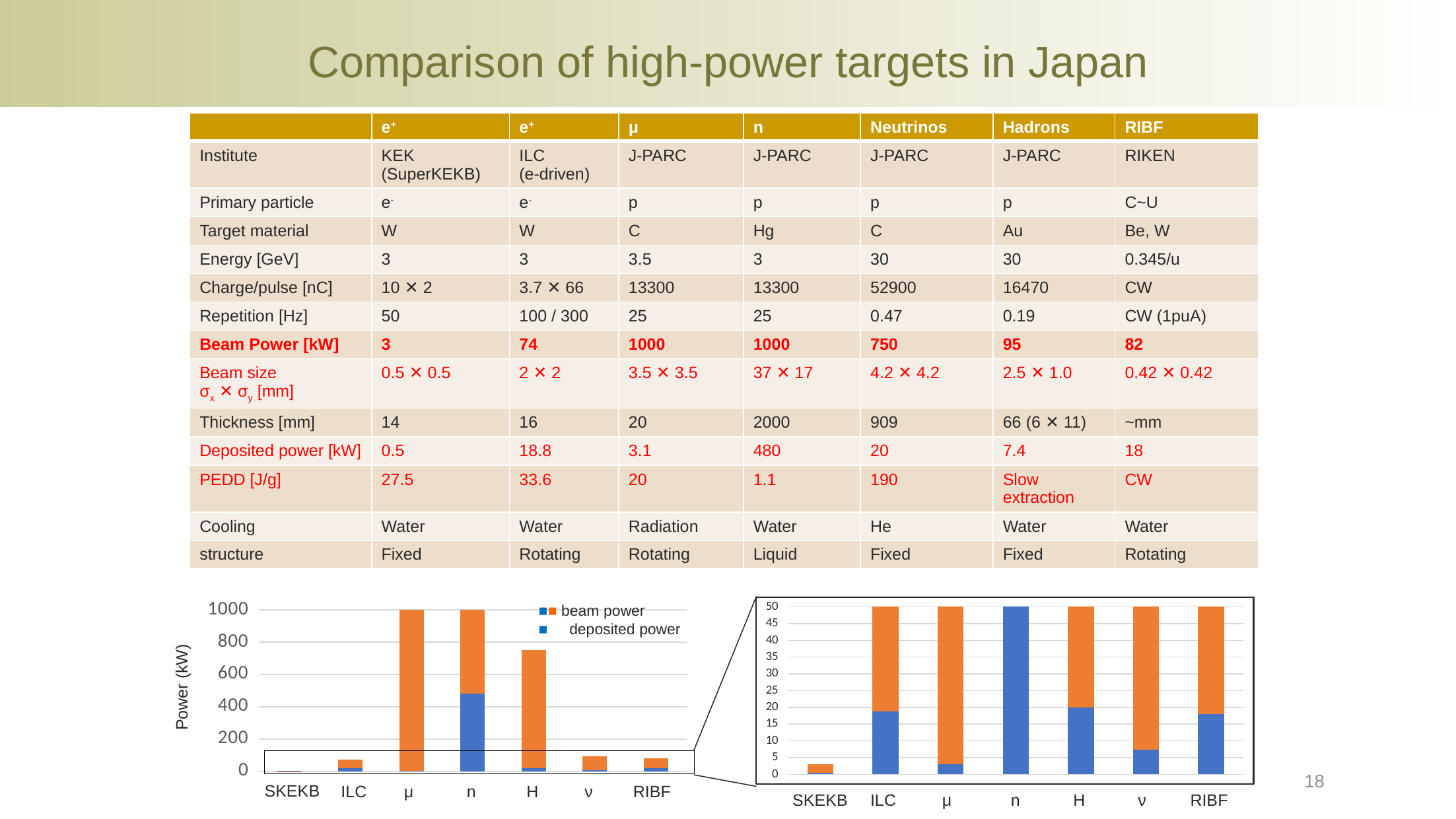
In the right (zoomed) chart, is the deposited power for ILC greater or less than 15? greater In the left chart, is the beam power for H greater or less than 600? greater In the left chart, which category has the lowest beam power? SKEKB In the right (zoomed) chart, is the deposited power for μ greater or less than 5? less What is the y-axis label of the left chart? Power (kW) What kind of chart is the left chart on the slide? bar chart In the left chart, which has the larger beam power, H or ν? H How many series does the legend of the left chart list? 2 In the left chart, what is the beam power value for μ? 1000 How many categories are shown on the x axis of the left chart? 7